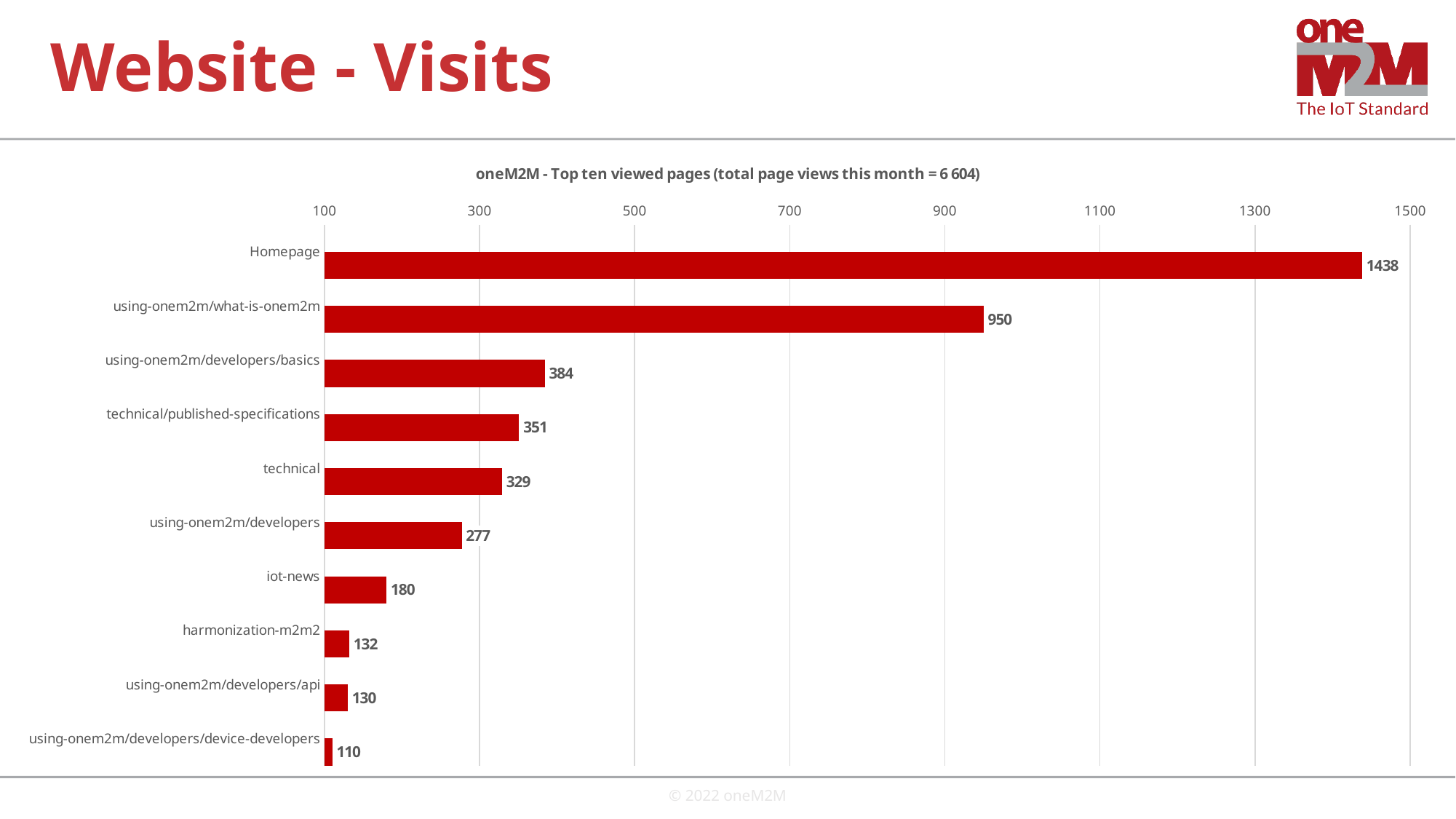
Which page has the lowest number of page views? using-onem2m/developers/device-developers What kind of chart is shown on the slide? Bar chart How many pages are shown in the chart? 10 Which has more page views, using-onem2m/developers/basics or using-onem2m/developers? using-onem2m/developers/basics What is the number of page views for iot-news? 180 What is the difference in page views between technical/published-specifications and technical? 22 Which page has the highest number of page views? Homepage What is the difference in page views between the Homepage and using-onem2m/what-is-onem2m? 488 What is the number of page views for using-onem2m/what-is-onem2m? 950 What is the number of page views for the Homepage? 1438 What is the title of the chart? oneM2M - Top ten viewed pages (total page views this month = 6 604) What colour are the bars in the chart? Red